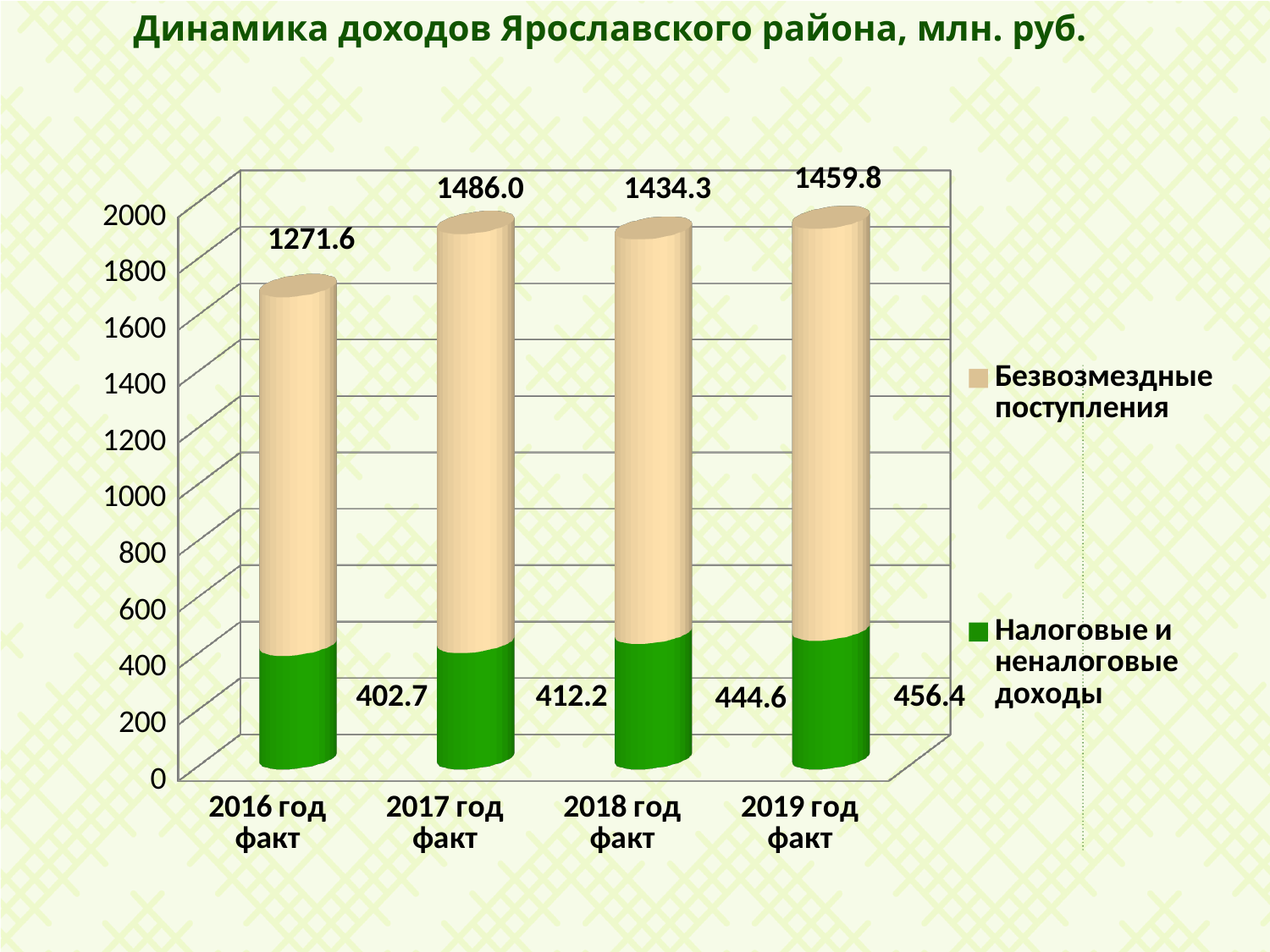
What kind of chart is shown on the slide? Stacked bar chart What is the total of the stacked bar for 2017 год факт? 1898.2 How many series does the legend list? 2 What is the difference between Налоговые и неналоговые доходы in 2019 год факт and 2016 год факт? 53.7 Which is larger: Безвозмездные поступления in 2018 год факт or in 2019 год факт? 2019 год факт Which year has the lowest value of Налоговые и неналоговые доходы? 2016 год факт How many years (categories) are shown on the x axis? 4 What is the value of Налоговые и неналоговые доходы for 2019 год факт? 456.4 What is the value of Безвозмездные поступления for 2016 год факт? 1271.6 Do the values of Налоговые и неналоговые доходы rise or fall from 2016 to 2019? Rise Which year has the highest value of Безвозмездные поступления? 2017 год факт What is the value of Безвозмездные поступления for 2018 год факт? 1434.3